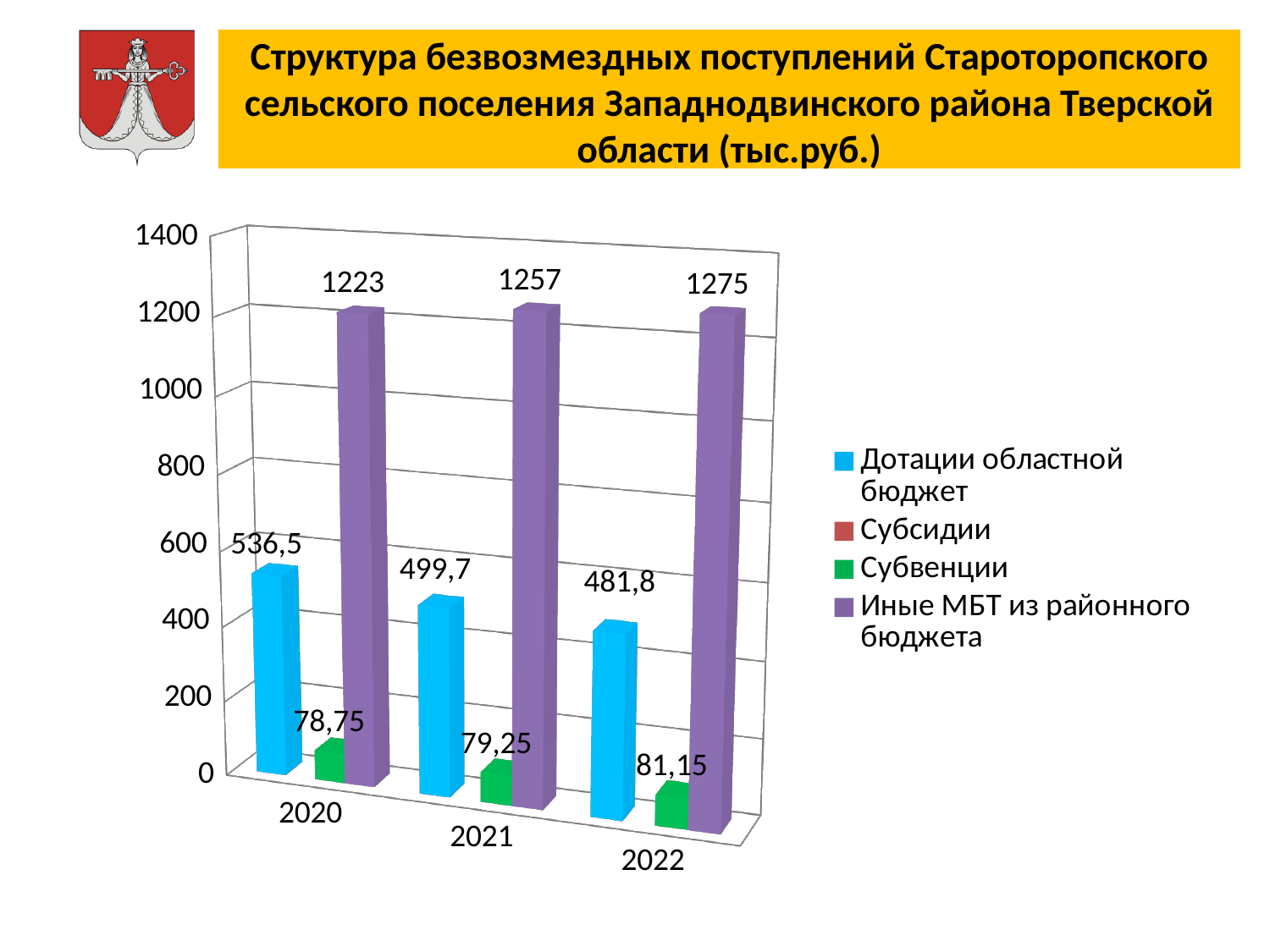
Which colour represents Иные МБТ из районного бюджета in the legend? Purple How many series does the legend list? 4 What is the value for Субвенции in 2021? 79,25 What is the difference between the Иные МБТ из районного бюджета values for 2022 and 2020? 52 What kind of chart is shown on the slide? Bar chart Which is larger: Дотации областной бюджет in 2021 or in 2022? 2021 In which year is the value for Иные МБТ из районного бюджета the highest? 2022 What is the value for Дотации областной бюджет in 2020? 536,5 What is the value for Иные МБТ из районного бюджета in 2022? 1275 How many years are shown on the x axis? 3 Do the values for Субвенции rise or fall from 2020 to 2022? Rise In which year is the value for Дотации областной бюджет the lowest? 2022